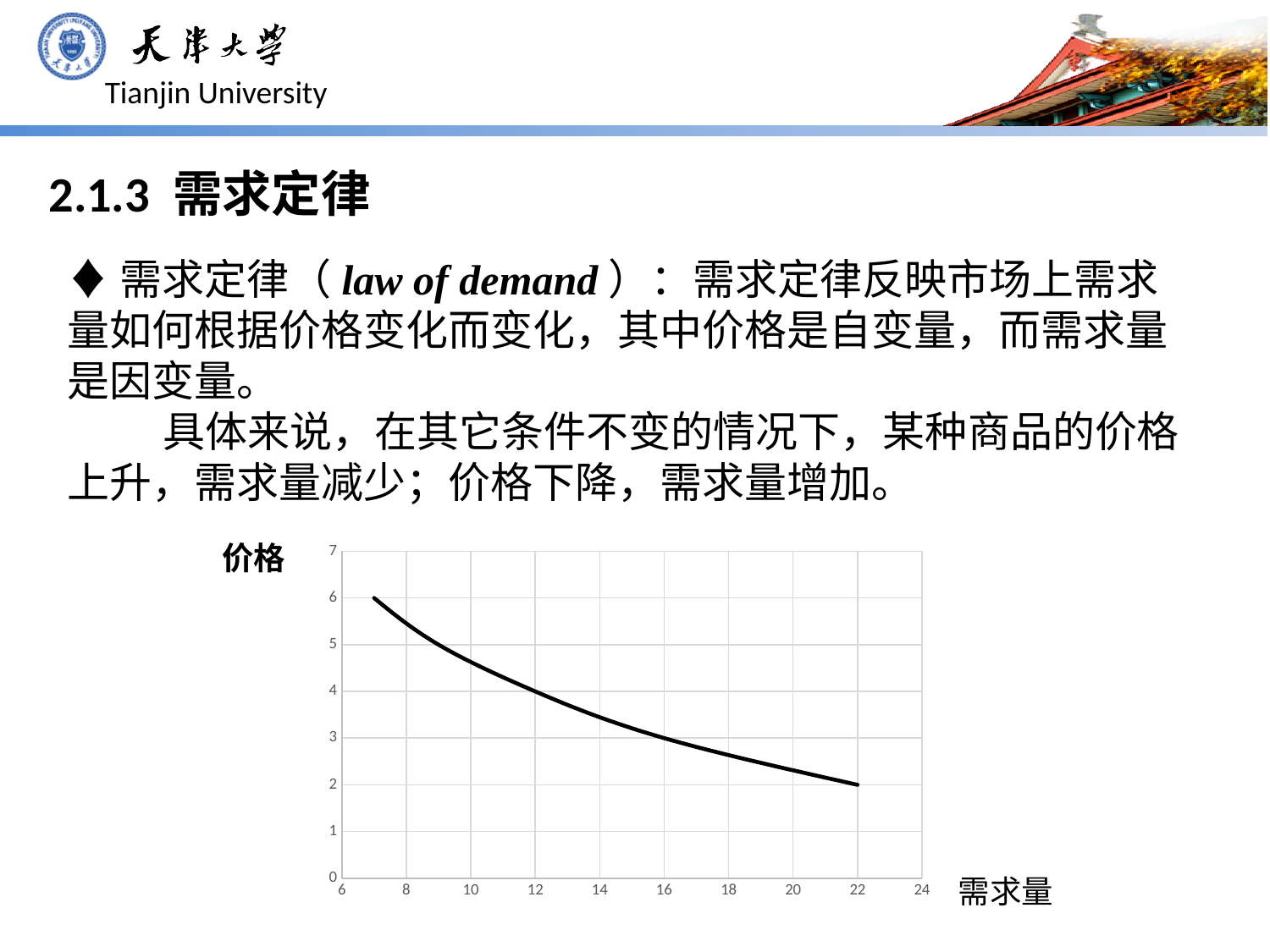
What is the label of the horizontal axis of the chart? 需求量 What is the label of the vertical axis of the chart? 价格 What is the highest 价格 value reached by the curve, at its left end? 6 Do the values on the curve rise or fall as 需求量 increases along the x axis? fall What kind of chart is shown on the slide? line chart Is the 价格 value at 需求量 = 20 greater or less than 2? greater Which is larger, the 价格 at 需求量 = 8 or the 价格 at 需求量 = 20? 需求量 = 8 Is the 价格 value at 需求量 = 18 greater or less than 3? less What is the lowest 价格 value reached by the curve, at its right end? 2 Is the 价格 value at 需求量 = 10 greater or less than 4? greater What is the 价格 value where the curve ends at 需求量 = 22? 2